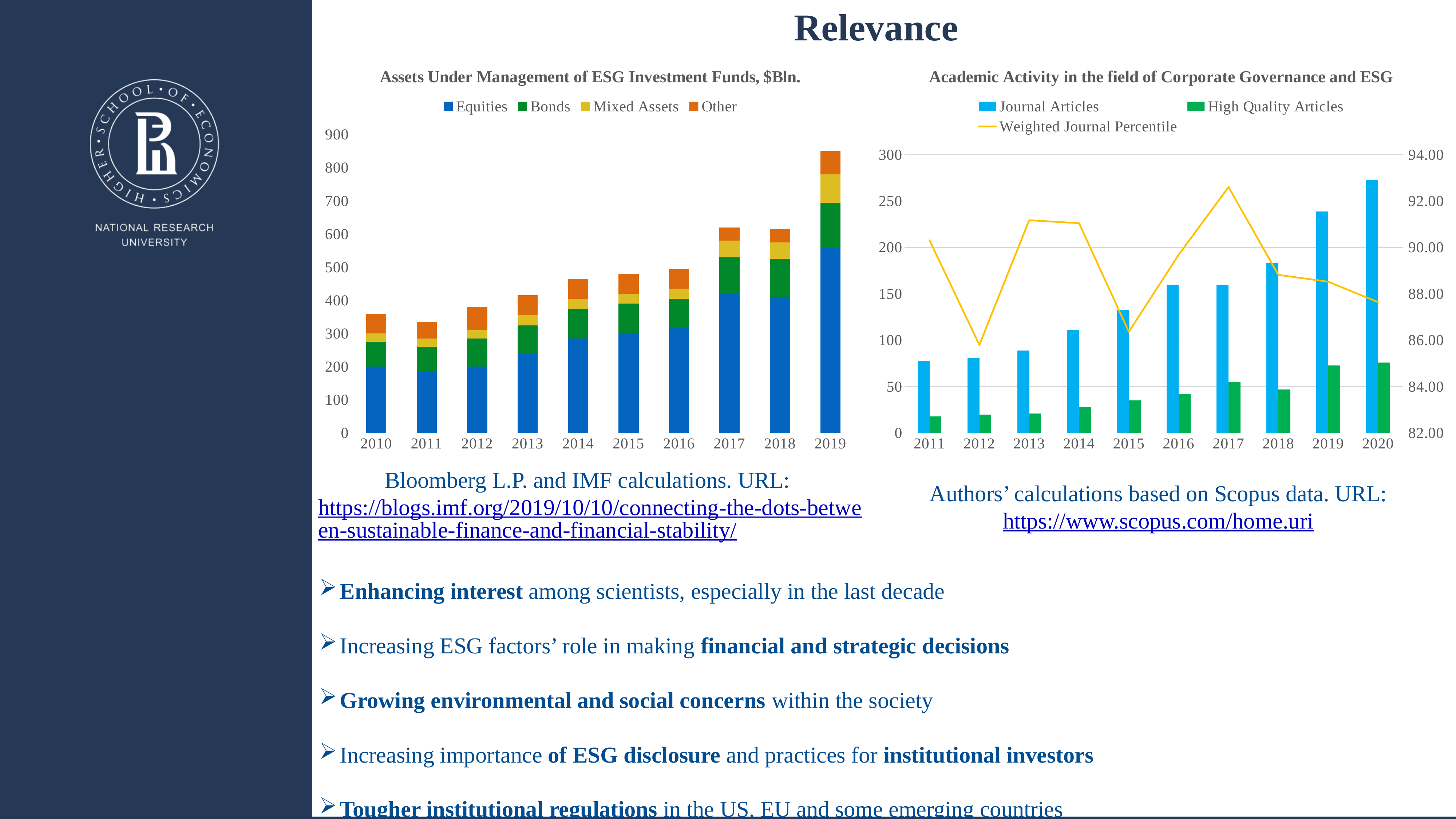
What kind of chart is the 'Assets Under Management of ESG Investment Funds, $Bln.' chart? Stacked bar chart In the 'Assets Under Management of ESG Investment Funds, $Bln.' chart, is the total stacked bar for 2019 greater or less than 800? greater How many series does the legend of the 'Assets Under Management of ESG Investment Funds, $Bln.' chart list? 4 In the 'Assets Under Management of ESG Investment Funds, $Bln.' chart, is the total stacked bar for 2010 greater or less than 400? less In the 'Academic Activity in the field of Corporate Governance and ESG' chart, which year has the highest Journal Articles bar? 2020 In the 'Assets Under Management of ESG Investment Funds, $Bln.' chart, which year has the tallest stacked bar? 2019 In the 'Academic Activity in the field of Corporate Governance and ESG' chart, in which year is the Weighted Journal Percentile line at its lowest? 2012 In the 'Academic Activity in the field of Corporate Governance and ESG' chart, is the Journal Articles value for 2020 greater or less than 250? greater How many years are shown on the x axis of the 'Assets Under Management of ESG Investment Funds, $Bln.' chart? 10 In the 'Assets Under Management of ESG Investment Funds, $Bln.' chart, which series is shown in blue at the bottom of each bar? Equities In the 'Assets Under Management of ESG Investment Funds, $Bln.' chart, which year has the shortest stacked bar? 2011 How many series does the legend of the 'Academic Activity in the field of Corporate Governance and ESG' chart list? 3